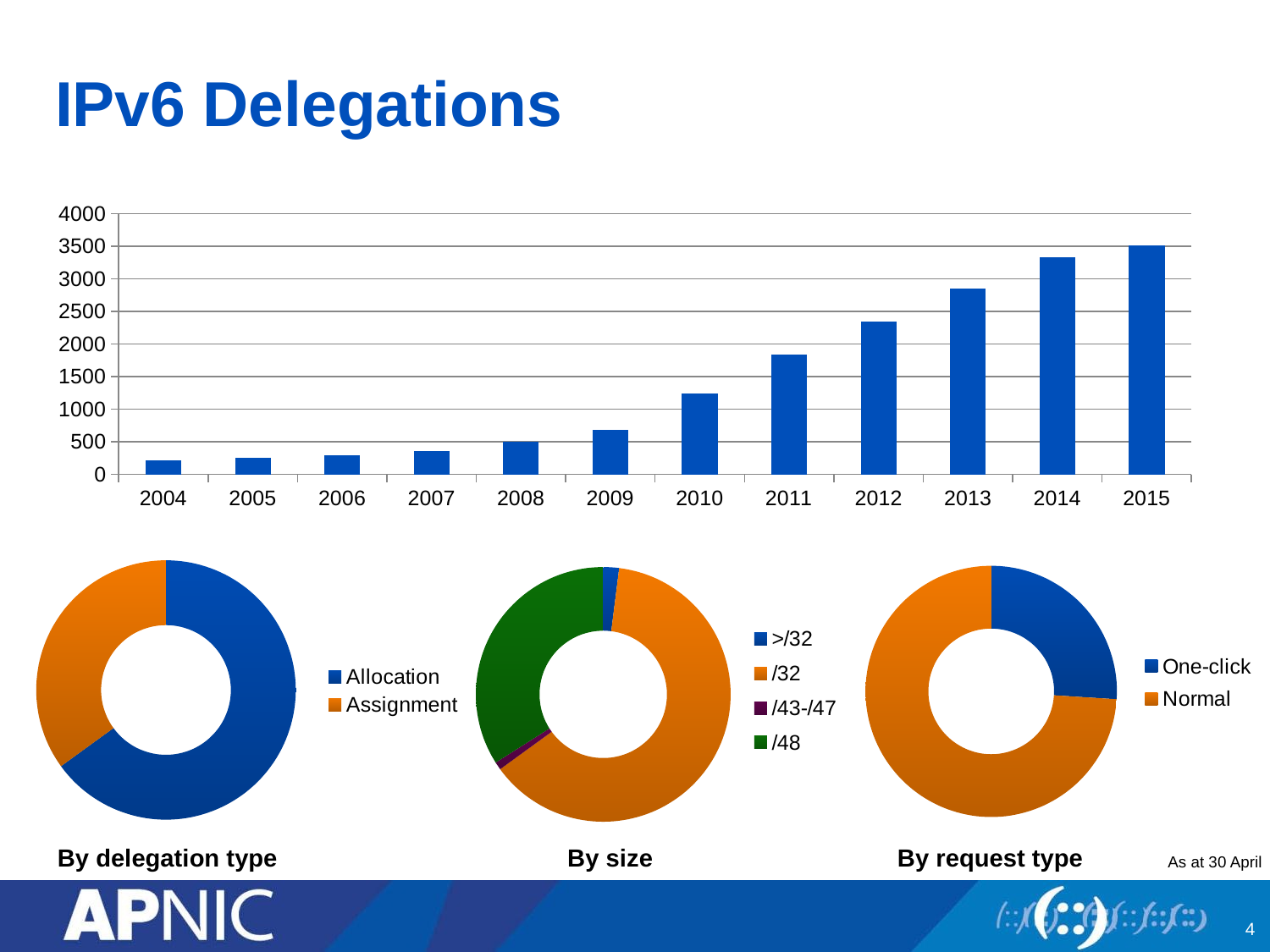
What kind of chart is the top chart on the slide? bar chart In the top bar chart, which year has the lowest value? 2004 How many entries does the legend of the 'By size' chart list? 4 In the 'By delegation type' chart, which is larger, Allocation or Assignment? Allocation In the top bar chart, is the value for 2014 greater or less than 3000? greater In the top bar chart, is the value for 2010 greater or less than 1000? greater In the top bar chart, is the value for 2012 greater or less than 2500? less How many years are shown on the x axis of the top bar chart? 12 In the top bar chart, which year has the highest value? 2015 In the top bar chart, do the values rise or fall from 2004 to 2015? rise In the 'By size' chart, which category has the largest share? /32